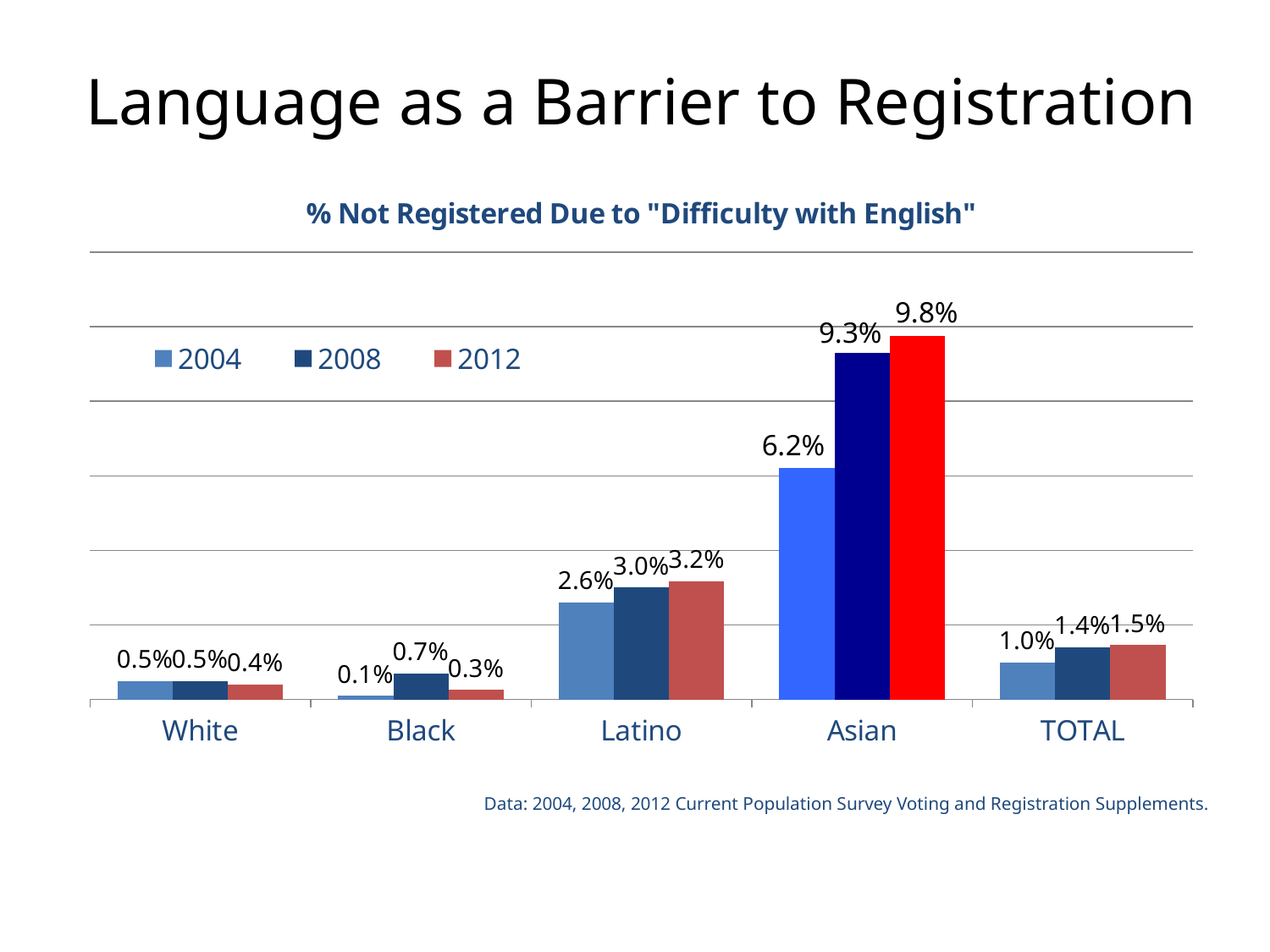
How many categories are shown on the x axis? 5 What is the 2004 value for Latino? 2.6% Which is larger for Latino: the 2008 value or the 2012 value? 2012 What is the 2012 value for TOTAL? 1.5% What is the difference between the 2012 and 2004 values for Asian? 3.6% What is the title of the chart? % Not Registered Due to "Difficulty with English" What kind of chart is this? Bar chart How many series does the legend list? 3 What is the 2012 value for Asian? 9.8% What is the 2008 value for Black? 0.7% Which category has the highest 2008 value? Asian Which category has the lowest 2004 value? Black